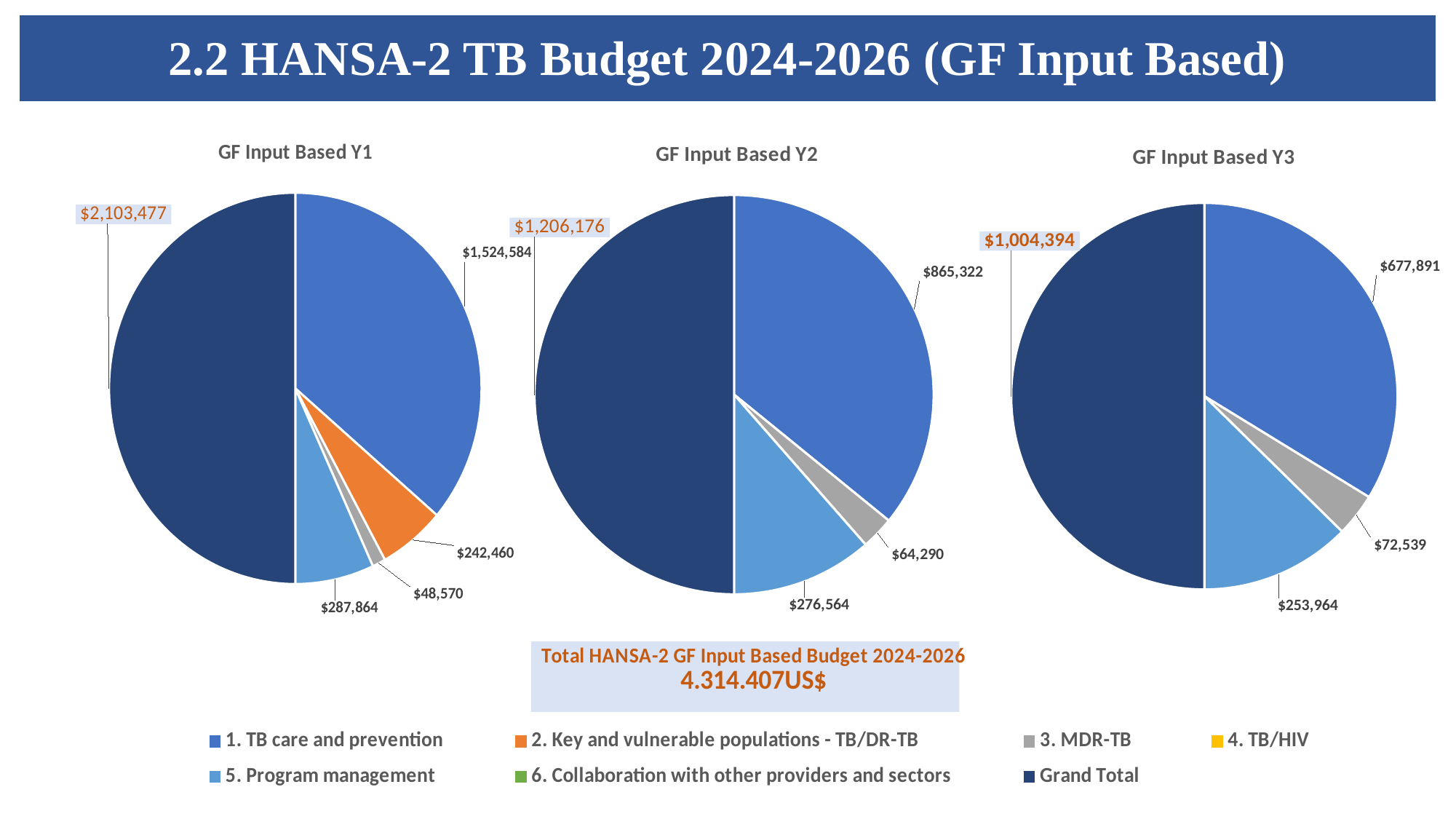
On the GF Input Based Y2 chart, what is the value for 5. Program management? $276,564 How many slices does the GF Input Based Y1 pie chart have? 5 On the GF Input Based Y1 chart, which slice is the smallest? 3. MDR-TB On the GF Input Based Y1 chart, what is the value for 2. Key and vulnerable populations - TB/DR-TB? $242,460 On the GF Input Based Y1 chart, which slice other than Grand Total is the largest? 1. TB care and prevention On the GF Input Based Y2 chart, what is the Grand Total value? $1,206,176 On the GF Input Based Y3 chart, what is the value for 3. MDR-TB? $72,539 On the GF Input Based Y2 chart, what is the difference between 5. Program management and 3. MDR-TB? $212,274 On the GF Input Based Y3 chart, what is the difference between 1. TB care and prevention and 5. Program management? $423,927 How many entries does the shared legend list? 7 On the GF Input Based Y3 chart, which is larger: 5. Program management or 3. MDR-TB? 5. Program management On the GF Input Based Y1 chart, what is the value for 1. TB care and prevention? $1,524,584